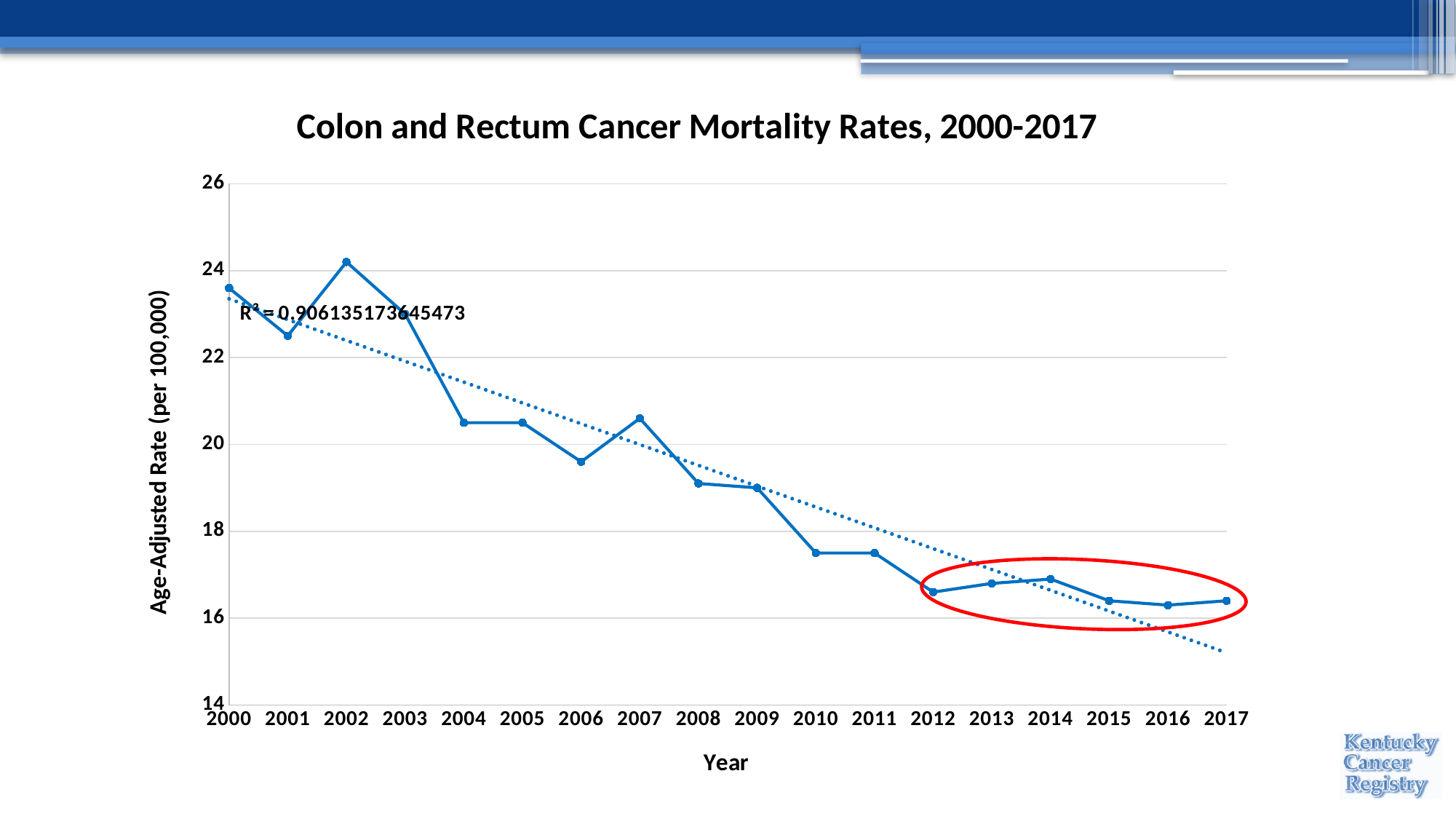
Overall, do the mortality rates rise or fall from 2000 to 2017? Fall What is the title of the chart? Colon and Rectum Cancer Mortality Rates, 2000-2017 What R² value is printed on the chart for the trend line? 0.906135173645473 Is the value for 2004 greater or less than 20? greater Which year has the larger mortality rate, 2002 or 2017? 2002 Which year has the highest age-adjusted mortality rate? 2002 How many years are plotted along the x axis? 18 Which year has the larger mortality rate, 2004 or 2010? 2004 What kind of chart is shown on the slide? Line chart Is the value for 2002 greater or less than 24? greater Is the value for 2006 greater or less than 20? less